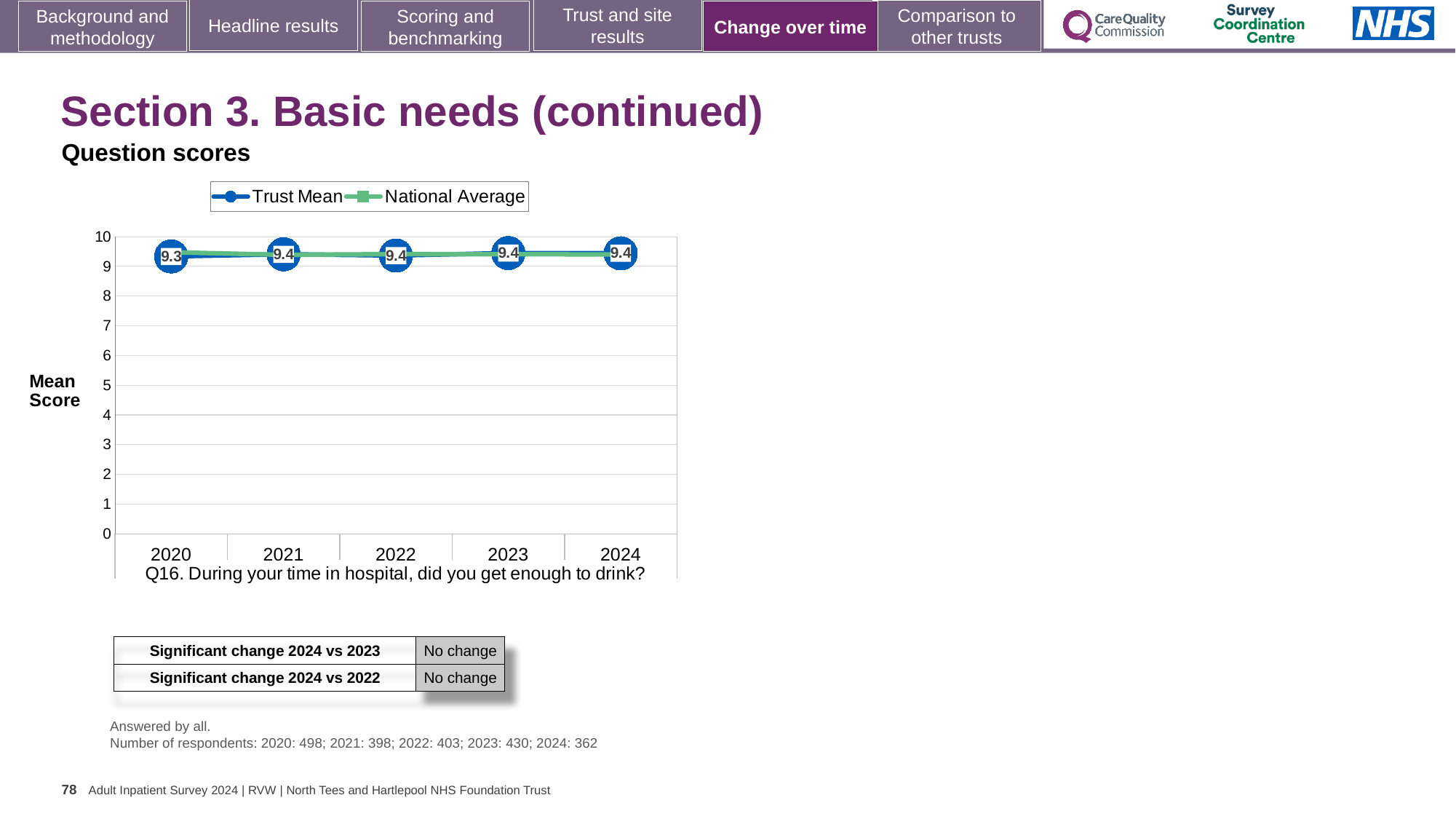
What is the Trust Mean score for 2020? 9.3 Which year has the lowest Trust Mean score? 2020 How many series does the legend list? 2 What is the difference between the Trust Mean score in 2024 and in 2020? 0.1 How many years are plotted on the x axis? 5 Which survey question does the chart show scores for? Q16. During your time in hospital, did you get enough to drink? What is the Trust Mean score for 2022? 9.4 Is the National Average value for 2024 greater or less than 9? greater Does the Trust Mean score rise or fall from 2020 to 2024? Rise What kind of chart is shown on the slide? Line chart Is the Trust Mean score for 2021 larger than the Trust Mean score for 2020? Yes What is the Trust Mean score for 2024? 9.4